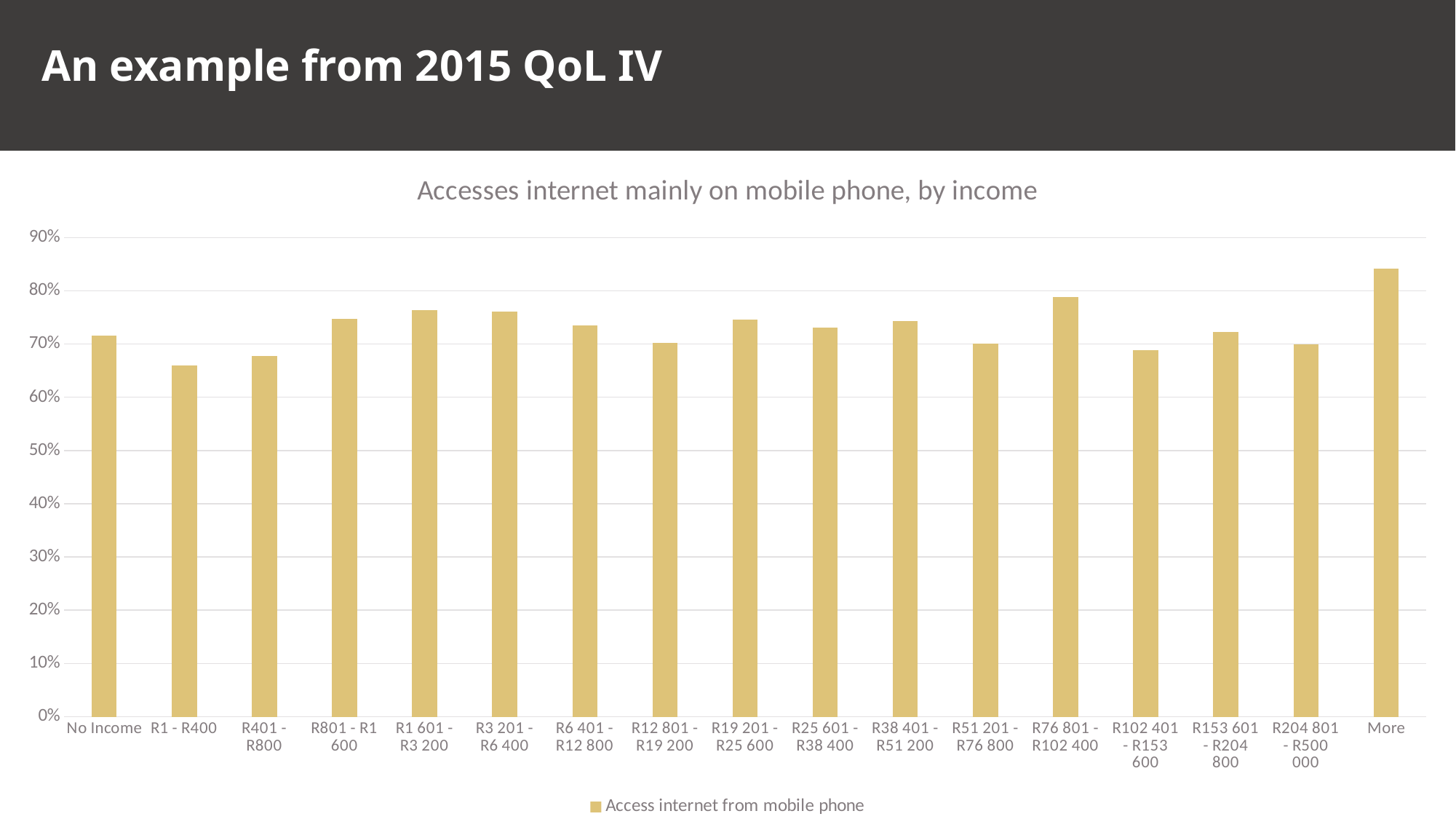
Which income category has the lowest value? R1 - R400 What kind of chart is shown on the slide? bar chart Is the value for R76 801 - R102 400 greater or less than 70%? greater What is the title of the chart? Accesses internet mainly on mobile phone, by income What is the legend entry for the series? Access internet from mobile phone Which is larger, the value for More or the value for No Income? More Is the value for R1 - R400 greater or less than 70%? less Is the value for More greater or less than 80%? greater Which is larger, the value for R801 - R1 600 or the value for R401 - R800? R801 - R1 600 How many income categories are shown on the x axis? 17 How many series does the legend list? 1 Which income category has the highest value? More